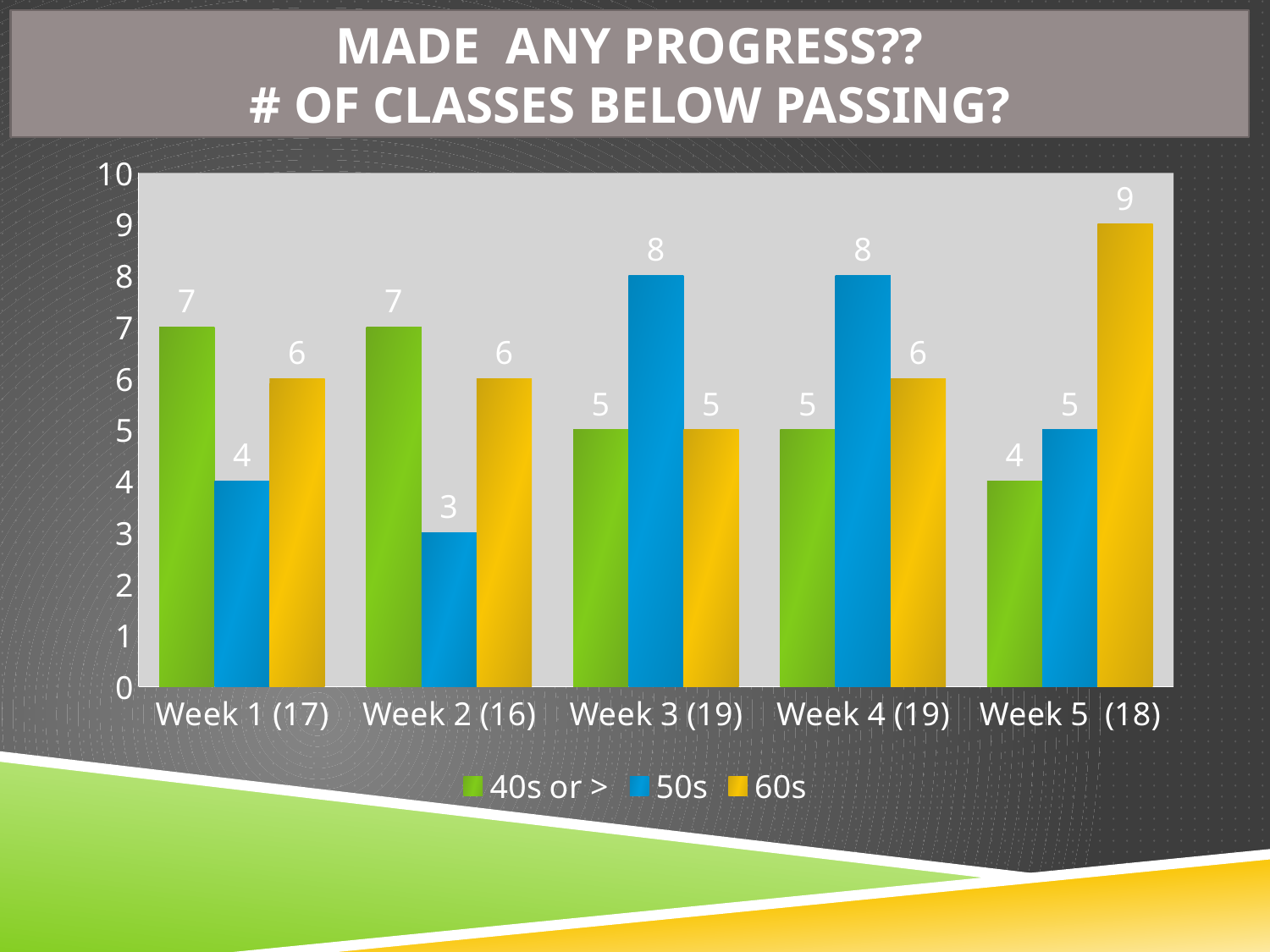
Does the 40s or > series rise or fall from Week 2 (16) to Week 5 (18)? Fall How many weeks are shown on the x axis? 5 In which week is the 60s series highest? Week 5 (18) What is the difference between the 60s value and the 40s or > value in Week 5 (18)? 5 What is the value for 40s or > in Week 1 (17)? 7 What is the value for 50s in Week 3 (19)? 8 Which is larger in Week 4 (19): the 50s value or the 60s value? 50s What is the value for 50s in Week 2 (16)? 3 How many series does the legend list? 3 What kind of chart is shown on the slide? Bar chart In which week is the 50s series lowest? Week 2 (16) What is the value for 60s in Week 5 (18)? 9